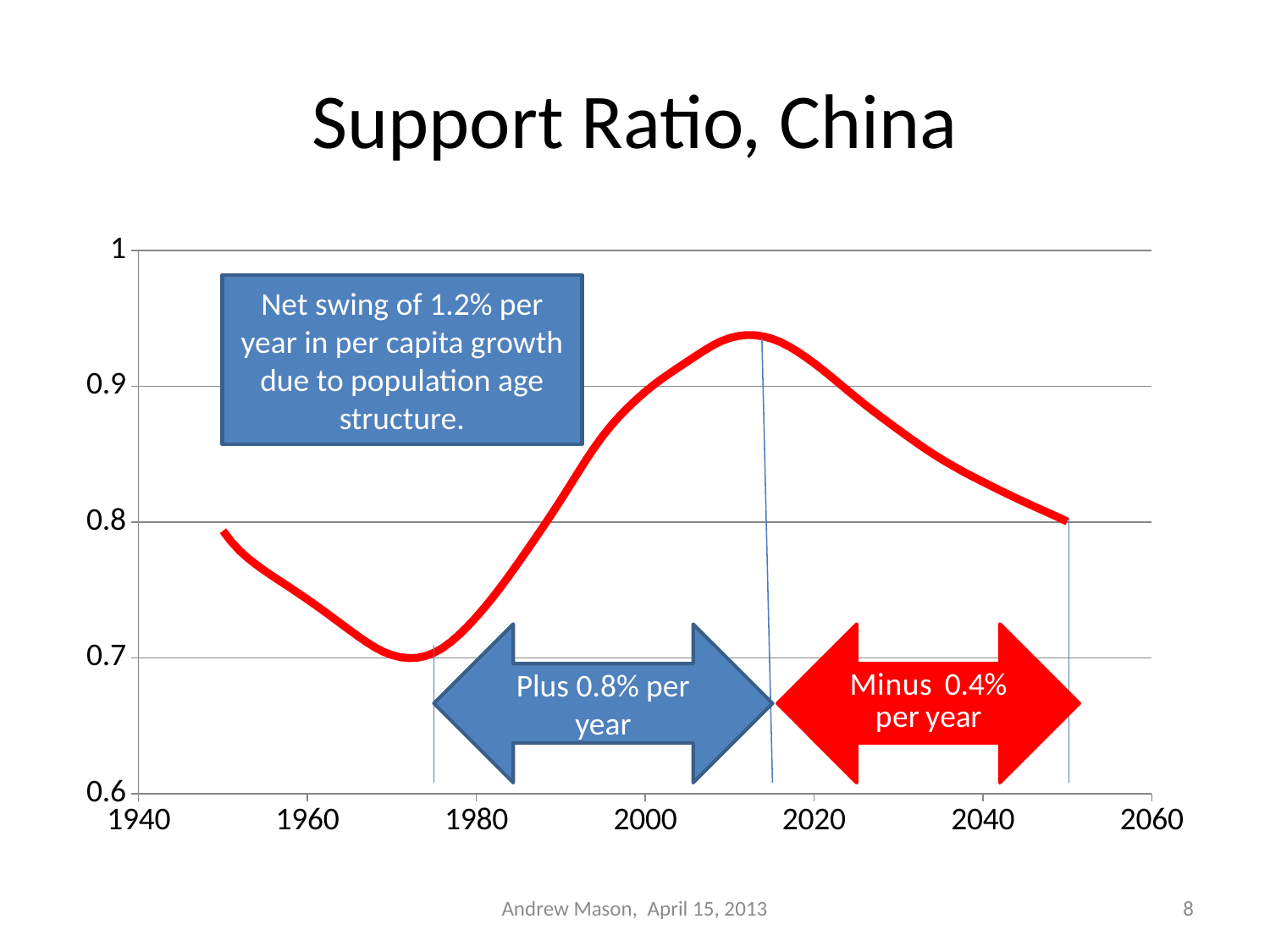
Which is larger, the support ratio around 1970 or around 2010? around 2010 Is the support ratio in 1950 greater or less than 0.9? less What is the title of the chart? Support Ratio, China Does the support ratio rise or fall between 1950 and 1970? fall Does the support ratio rise or fall between 2020 and 2050? fall What does the blue arrow on the chart say? Plus 0.8% per year What kind of chart is shown on the slide? line chart Is the support ratio around 1970 greater or less than 0.8? less In which decade does the line reach its lowest value? 1970s Is the support ratio in 2050 greater or less than 0.9? less Does the support ratio rise or fall between 1980 and 2010? rise